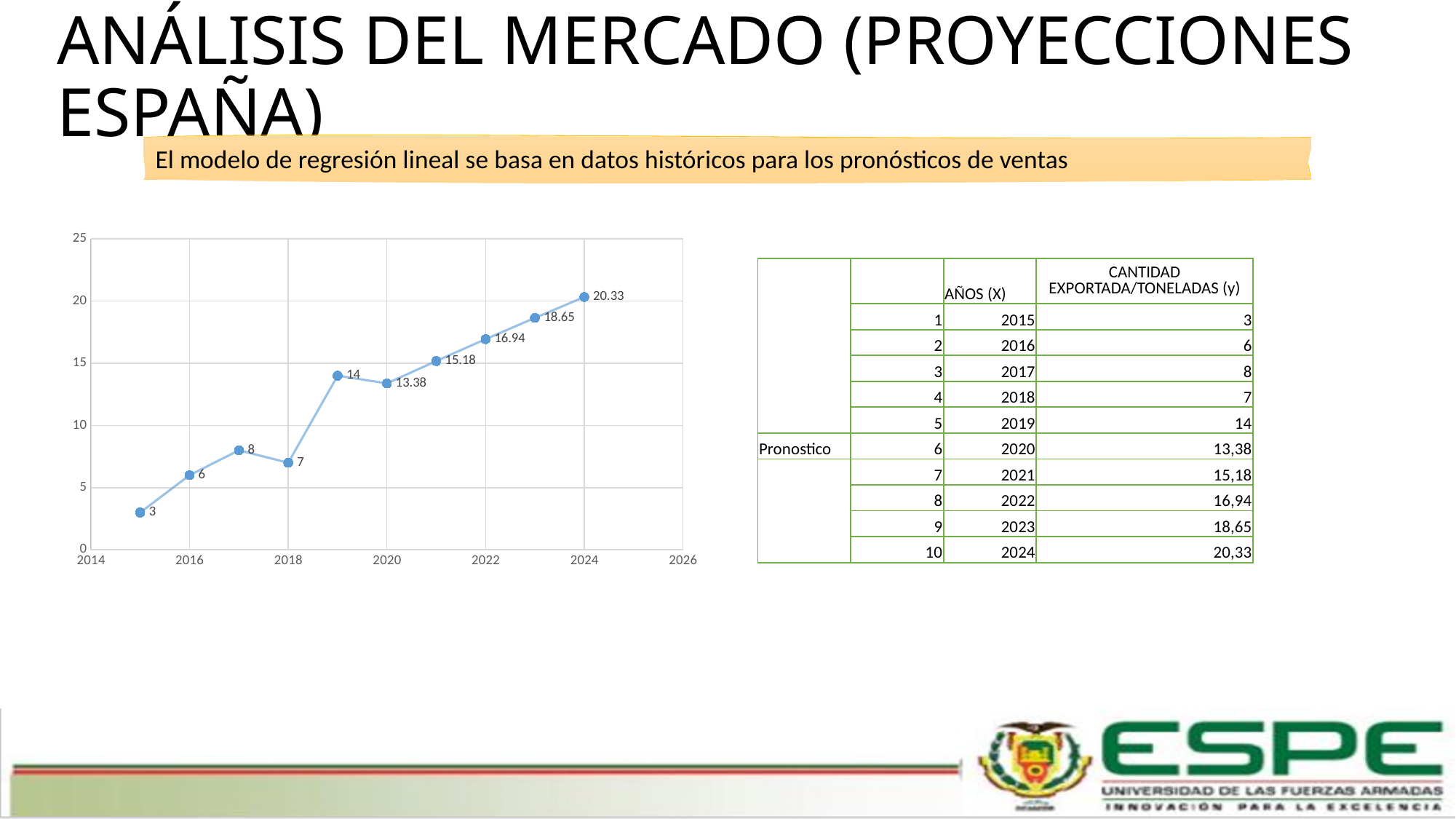
What is the difference between the values for 2024 and 2023? 1.68 What type of chart is shown on the slide? line chart How many data points are plotted on the chart? 10 Overall, do the plotted values rise or fall from 2015 to 2024? rise What is the value plotted for 2024? 20.33 What is the value plotted for 2019? 14 Which is larger, the value for 2017 or the value for 2018? 2017 What is the value plotted for 2015? 3 Which year has the highest plotted value? 2024 Which year has the lowest plotted value? 2015 What is the difference between the values for 2019 and 2018? 7 What is the value plotted for 2020? 13.38